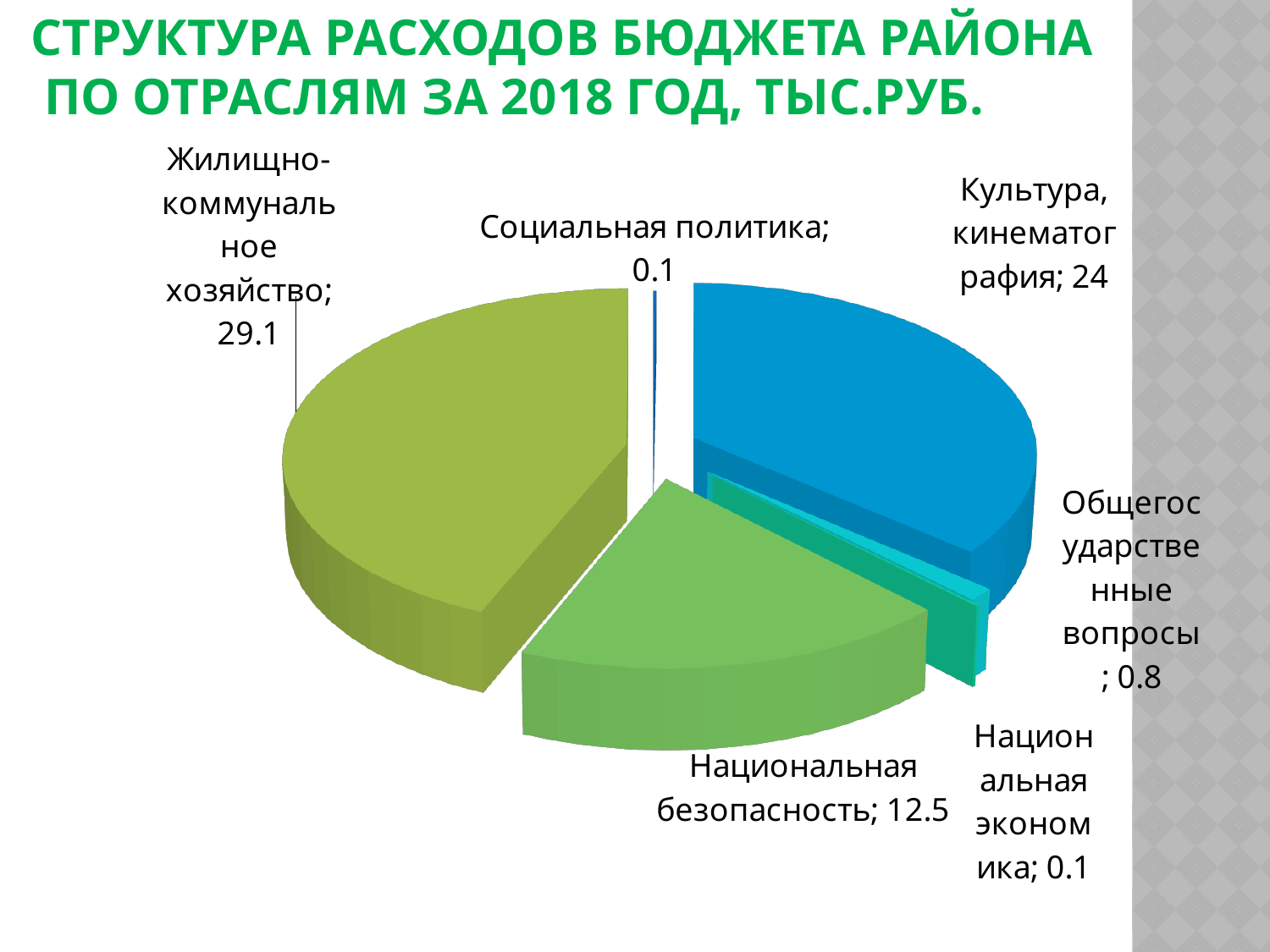
What is the value for Национальная безопасность? 12.5 What kind of chart is shown on the slide? pie chart What is the difference between the values for Жилищно-коммунальное хозяйство and Культура, кинематография? 5.1 What is the value for Общегосударственные вопросы? 0.8 Which is larger, the value for Национальная безопасность or the value for Общегосударственные вопросы? Национальная безопасность What is the difference between the values for Культура, кинематография and Национальная безопасность? 11.5 How many categories are shown in the pie chart? 6 What is the title of the chart on the slide? СТРУКТУРА РАСХОДОВ БЮДЖЕТА РАЙОНА ПО ОТРАСЛЯМ ЗА 2018 ГОД, ТЫС.РУБ. What is the value for Социальная политика? 0.1 Which category has the largest slice of the pie? Жилищно-коммунальное хозяйство What is the value for Жилищно-коммунальное хозяйство? 29.1 What is the value for Культура, кинематография? 24